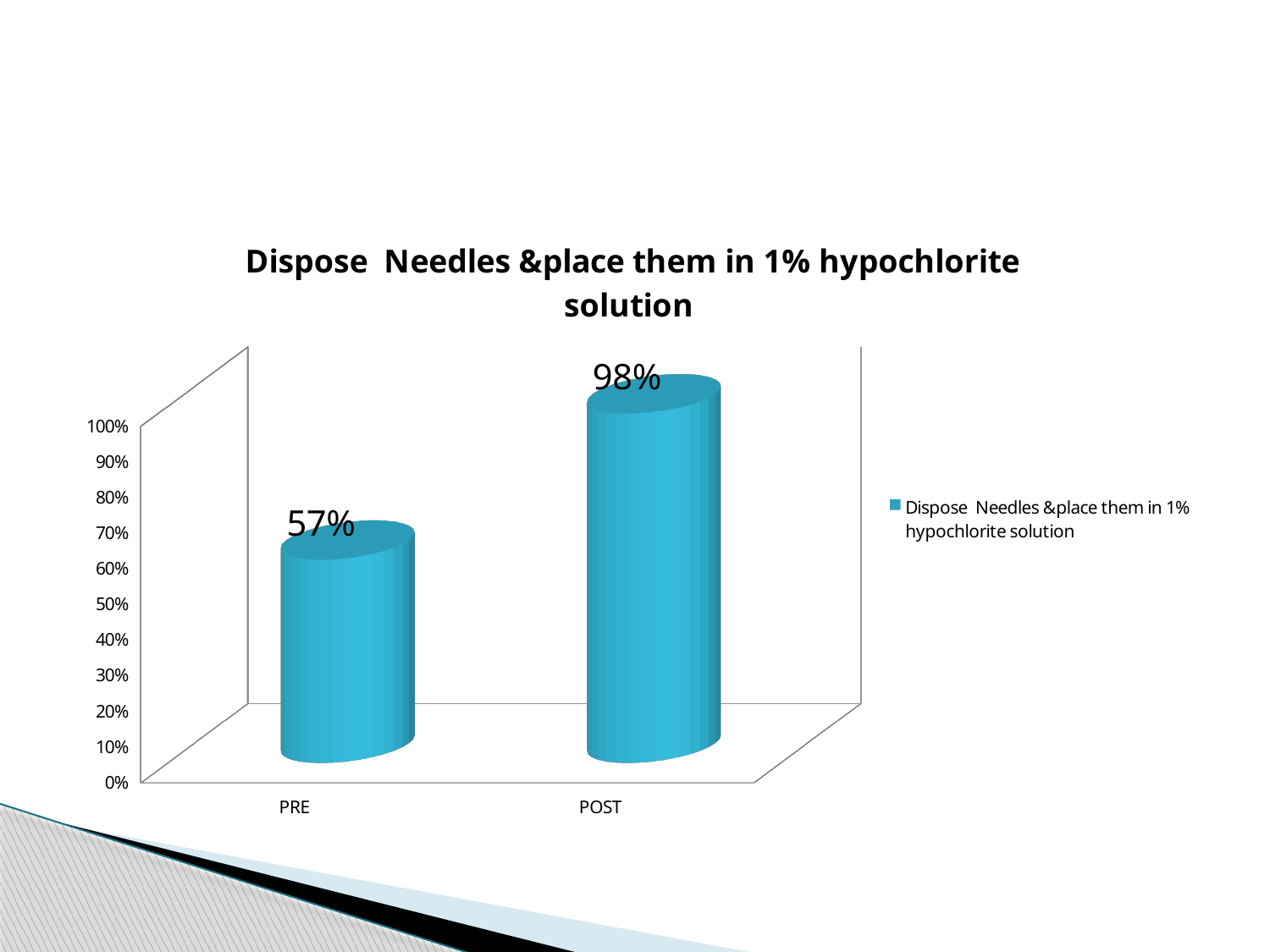
What is the value for POST? 98% How many series does the legend list? 1 Do the values rise or fall from PRE to POST? Rise How many categories are shown on the x axis? 2 What is the title of the chart? Dispose Needles &place them in 1% hypochlorite solution Which is larger, the value for PRE or the value for POST? POST What is the difference between the POST and PRE values? 41% Is the value for PRE greater or less than 50%? greater Which category has the lowest value? PRE What is the value for PRE? 57% Which category has the highest value? POST What kind of chart is shown on the slide? Bar chart